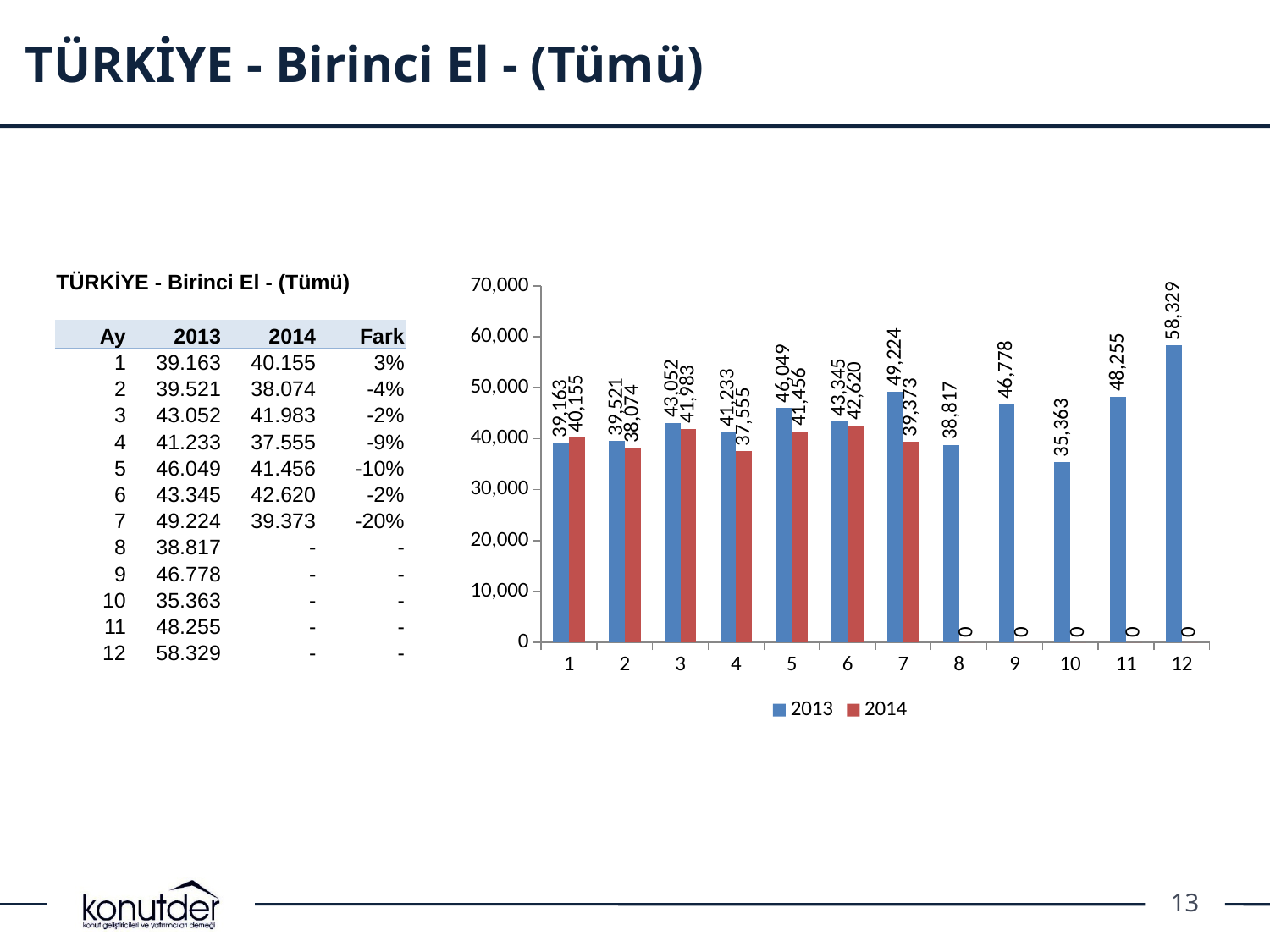
Which month has the highest 2014 value in the chart? 6 Is the 2013 value for month 9 greater or less than 40,000? greater Which month has the lowest 2013 value in the chart? 10 What is the difference between the 2013 and 2014 values for month 7? 9,851 What type of chart is shown on the slide? bar chart Which is larger for month 1: the 2013 value or the 2014 value? 2014 What colour are the 2014 bars in the chart? red Which month has the highest 2013 value in the chart? 12 How many series does the chart legend list? 2 What is the 2013 value for month 12 in the chart? 58,329 How many months are shown on the x axis of the chart? 12 What is the 2014 value for month 4 in the chart? 37,555